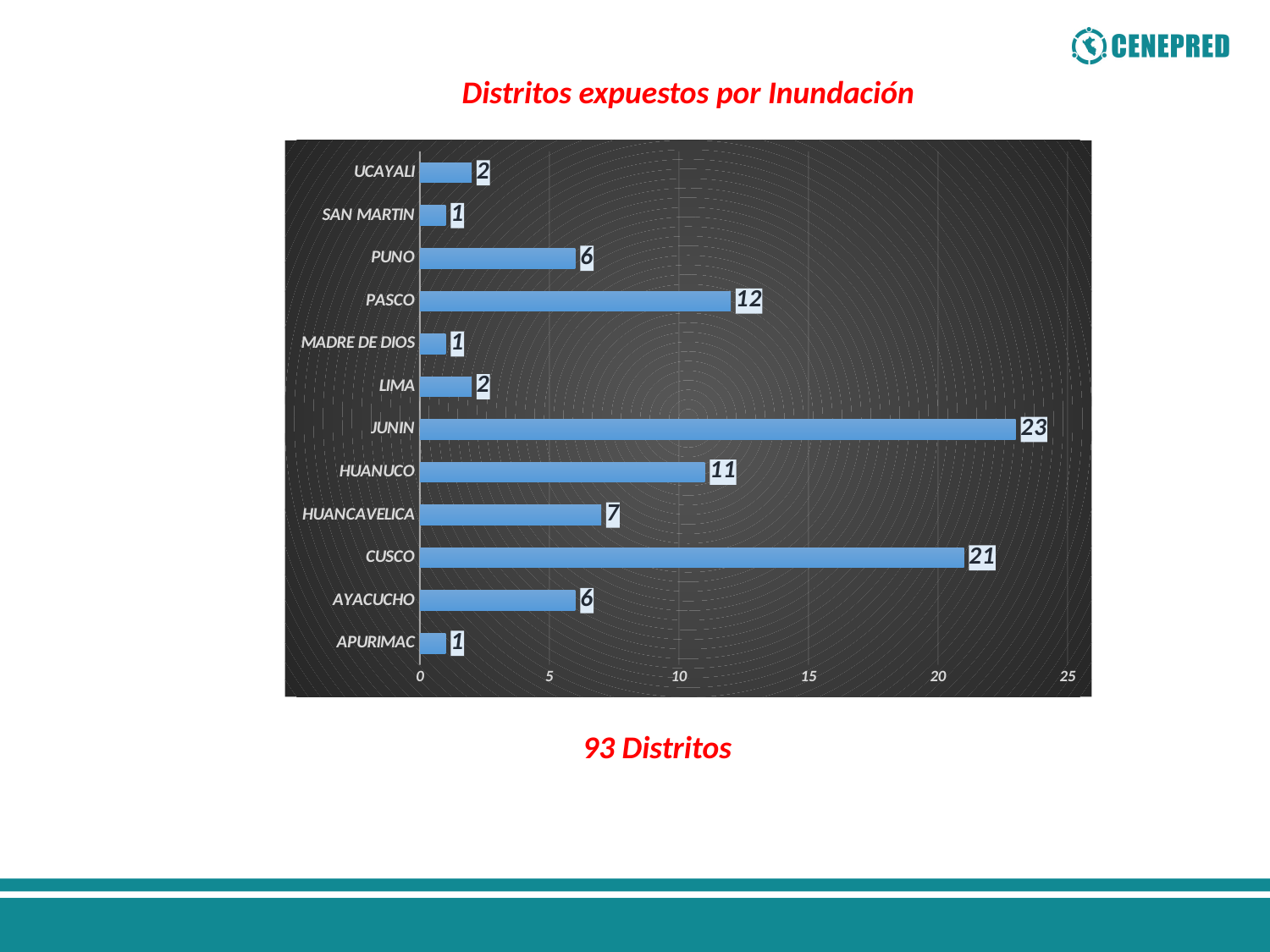
What is the title of the chart? Distritos expuestos por Inundación What is the difference between the values for PASCO and HUANUCO? 1 What is the value for PASCO? 12 How many categories are shown in the chart? 12 What total number of districts is stated below the chart? 93 Distritos What is the value for JUNIN? 23 What is the difference between the values for JUNIN and CUSCO? 2 What is the value for HUANCAVELICA? 7 What kind of chart is shown on the slide? bar chart Is the value for CUSCO greater or less than 20? greater Which is larger, the value for PUNO or the value for HUANCAVELICA? HUANCAVELICA Which category has the highest value? JUNIN